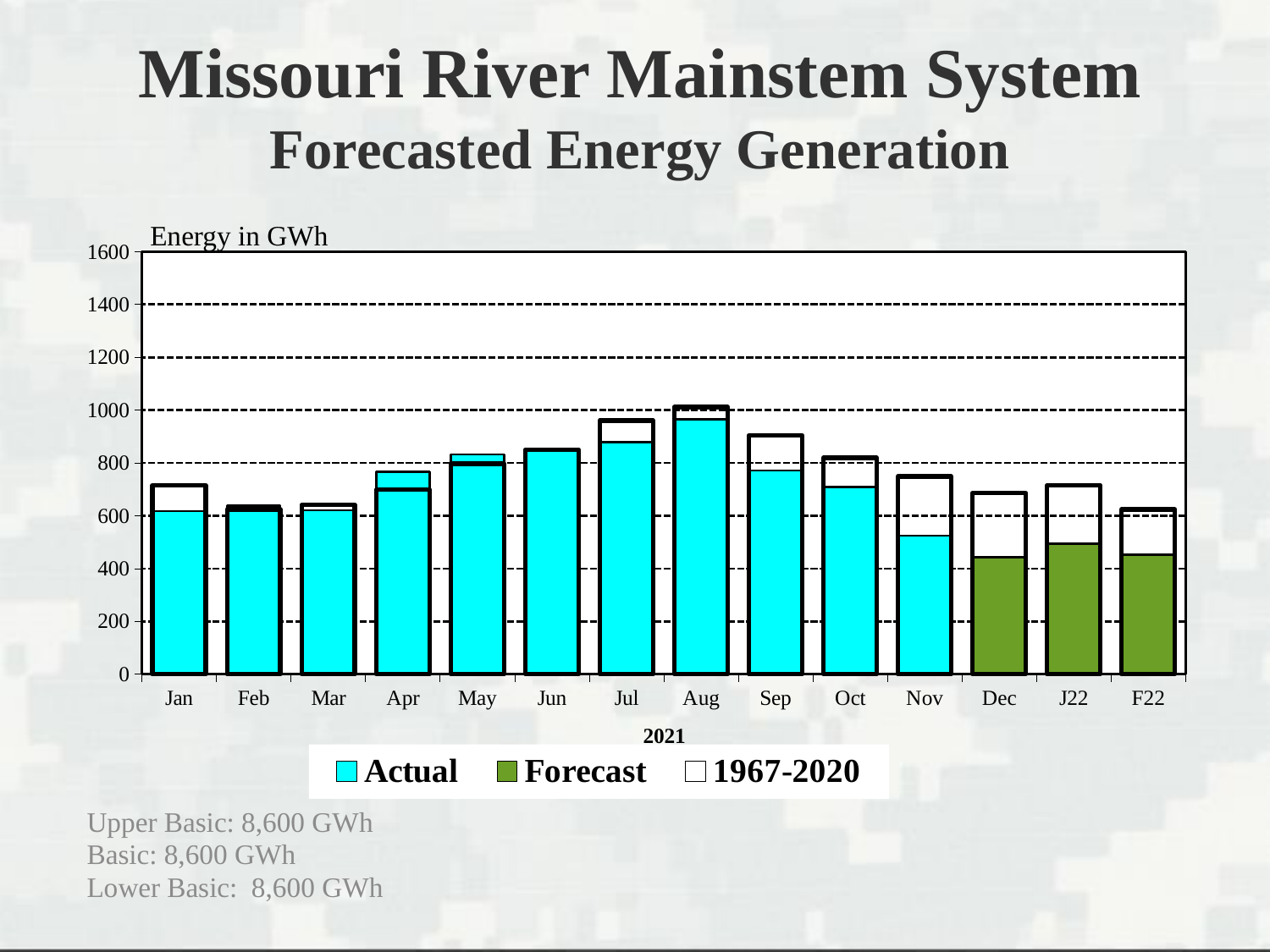
What unit is the y axis labelled with? Energy in GWh Is the Forecast value for Dec greater or less than 600? less How many months (categories) are shown along the x axis? 14 Is the Actual value for Nov greater or less than 600? less Is the 1967-2020 value for Sep greater or less than 800? greater Which month has the lowest Actual energy generation? Nov What kind of chart is shown on the slide? bar chart Do the Actual values rise or fall from Aug to Nov? fall Which month has the highest Actual energy generation? Aug How many series does the legend list? 3 Which is larger, the Actual value for Jul or the Actual value for Apr? Jul